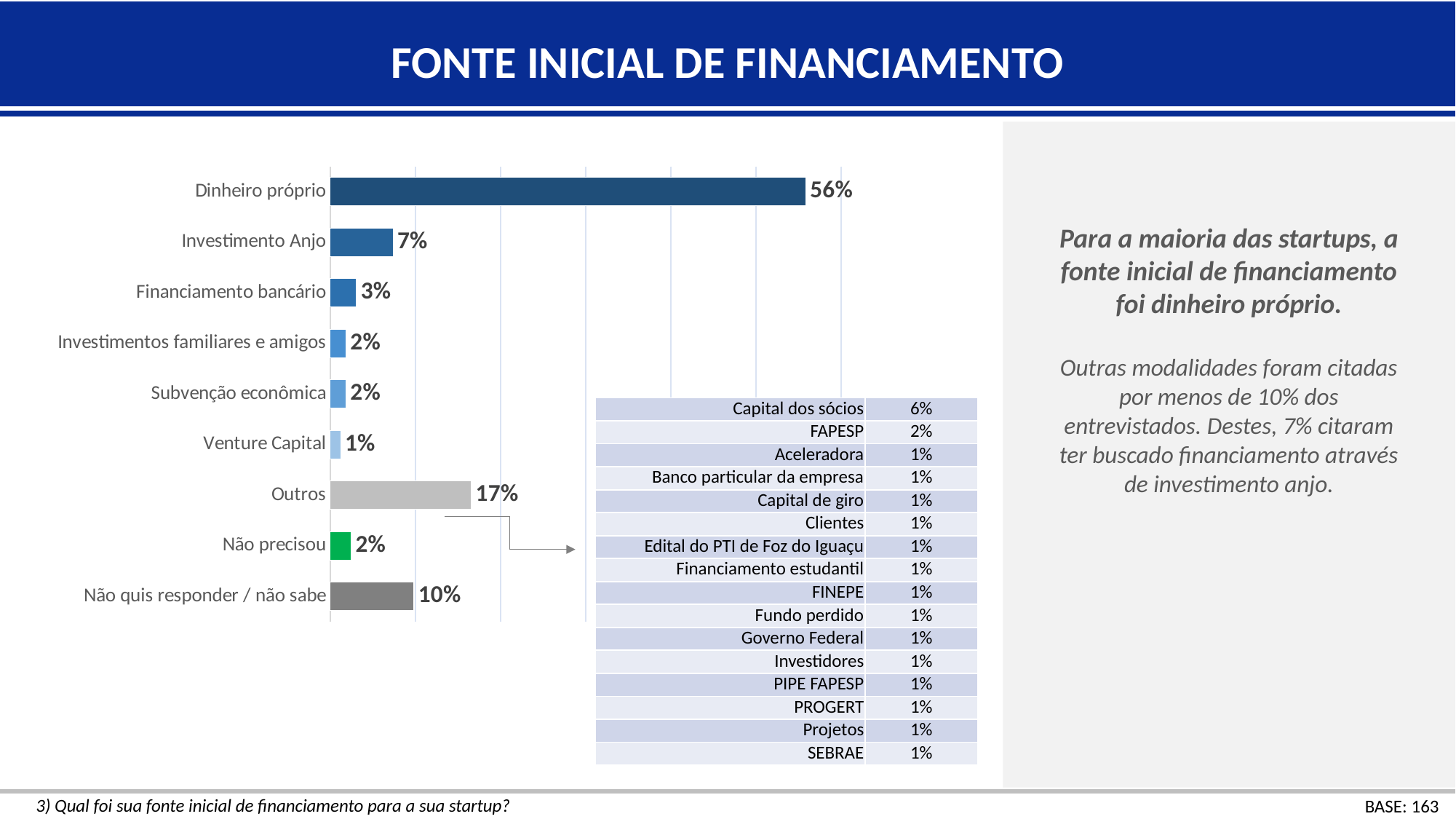
What is the value for Investimento Anjo? 7% Which is larger, Outros or Não quis responder / não sabe? Outros What kind of chart is shown on the slide? bar chart How many categories are shown in the bar chart? 9 Which category has the lowest value? Venture Capital Which category has the highest value? Dinheiro próprio What is the value for Não quis responder / não sabe? 10% In the table breaking down Outros, what is the value for Capital dos sócios? 6% What colour is the bar for Não precisou? green What is the value for Outros? 17% What is the difference between Dinheiro próprio and Investimento Anjo? 49 percentage points What is the value for Dinheiro próprio? 56%